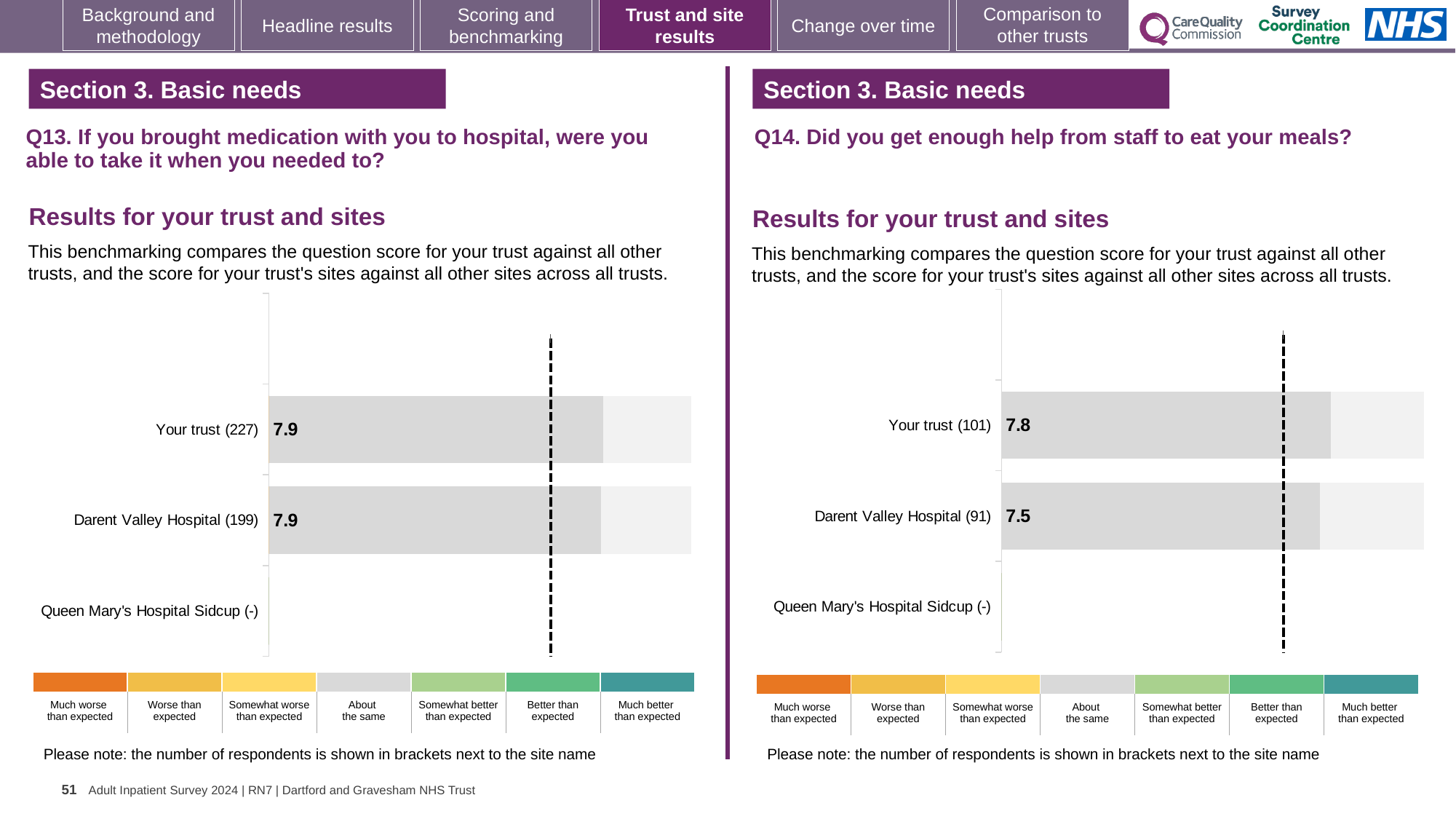
In the Q14 chart on the right, how many respondents are shown in brackets for Darent Valley Hospital? 91 In the Q14 chart on the right, what is the difference between the scores for Your trust and Darent Valley Hospital? 0.3 In the Q13 chart on the left, is the score for Your trust the same as the score for Darent Valley Hospital? Yes How many categories (rows) are listed on the y axis of the Q13 chart on the left? 3 In the Q14 chart on the right, which category has the lowest printed score? Darent Valley Hospital What kind of chart is used for the Q14 results on the right? Bar chart In the Q14 chart on the right, what is the score for Your trust? 7.8 In the Q14 chart on the right, what is the score for Darent Valley Hospital? 7.5 In the Q13 chart on the left, what is the score for Darent Valley Hospital? 7.9 In the Q13 chart on the left, how many respondents are shown in brackets for Your trust? 227 In the Q14 chart on the right, which has the higher score, Your trust or Darent Valley Hospital? Your trust In the Q13 chart on the left, what is the score for Your trust? 7.9